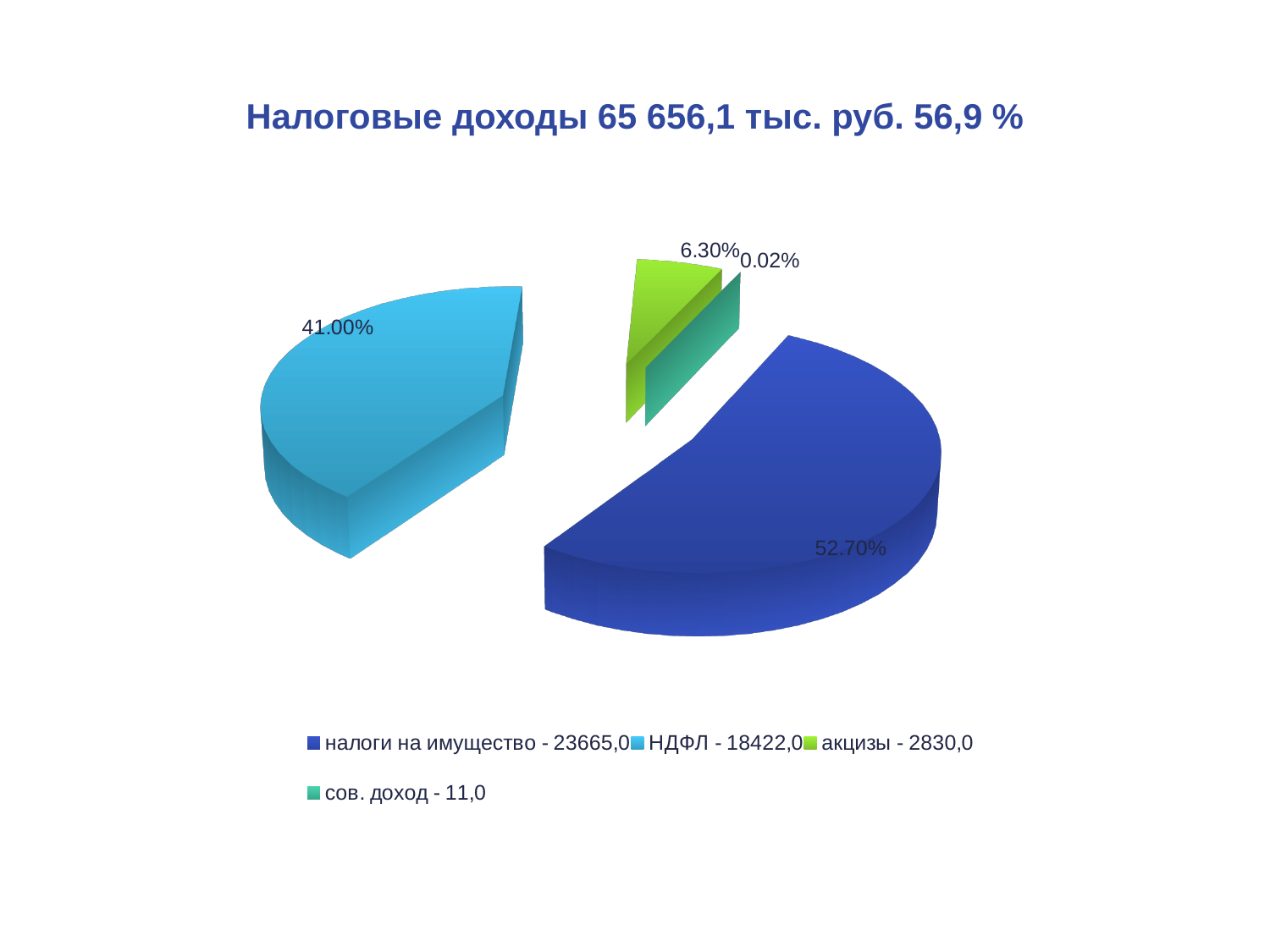
What kind of chart is shown on the slide? pie chart What is the title of the chart? Налоговые доходы 65 656,1 тыс. руб. 56,9 % What is the difference in percentage points between the налоги на имущество slice and the НДФЛ slice? 11.70% Which category has the smallest slice of the pie? сов. доход What percentage share is labelled on the slice for НДФЛ? 41.00% Which category has the largest slice of the pie? налоги на имущество How many slices does the pie chart have? 4 Which slice is larger, НДФЛ or акцизы? НДФЛ What percentage share is labelled on the slice for акцизы? 6.30% What percentage share is labelled on the slice for налоги на имущество? 52.70% What value is given for акцизы in the legend? 2830,0